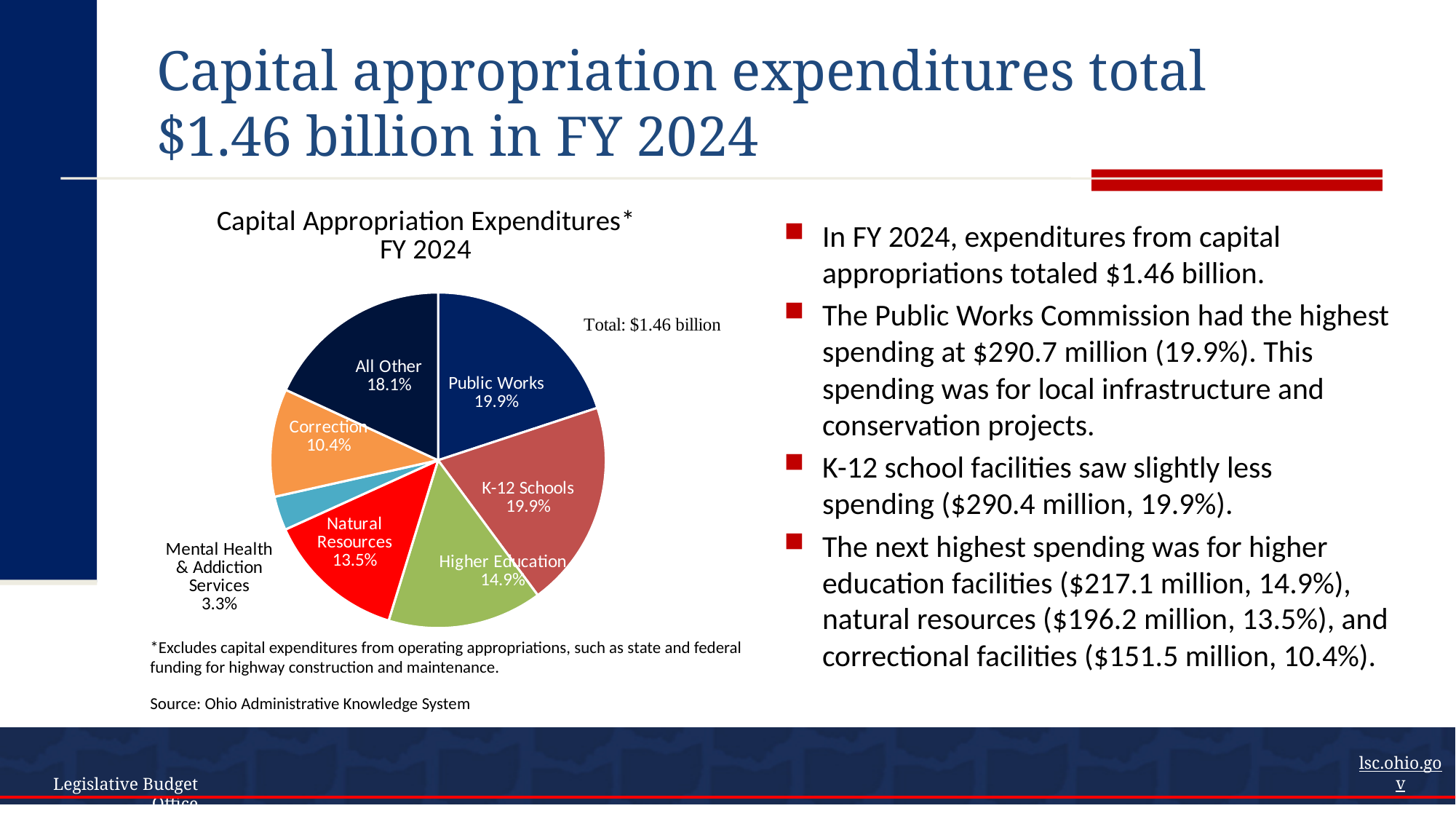
What share of capital appropriation expenditures went to Higher Education? 14.9% Which slice is larger, Higher Education or Natural Resources? Higher Education What percentage of the pie is Natural Resources? 13.5% Which category has the smallest slice of the pie? Mental Health & Addiction Services What is the difference in percentage points between All Other and Correction? 7.7 What share does the Correction slice represent? 10.4% How many slices does the pie chart have? 7 What kind of chart is shown on the slide? Pie chart What is the title of the pie chart? Capital Appropriation Expenditures* FY 2024 What total amount is noted next to the pie chart? $1.46 billion What share of expenditures went to Mental Health & Addiction Services? 3.3% What percentage is shown for All Other? 18.1%